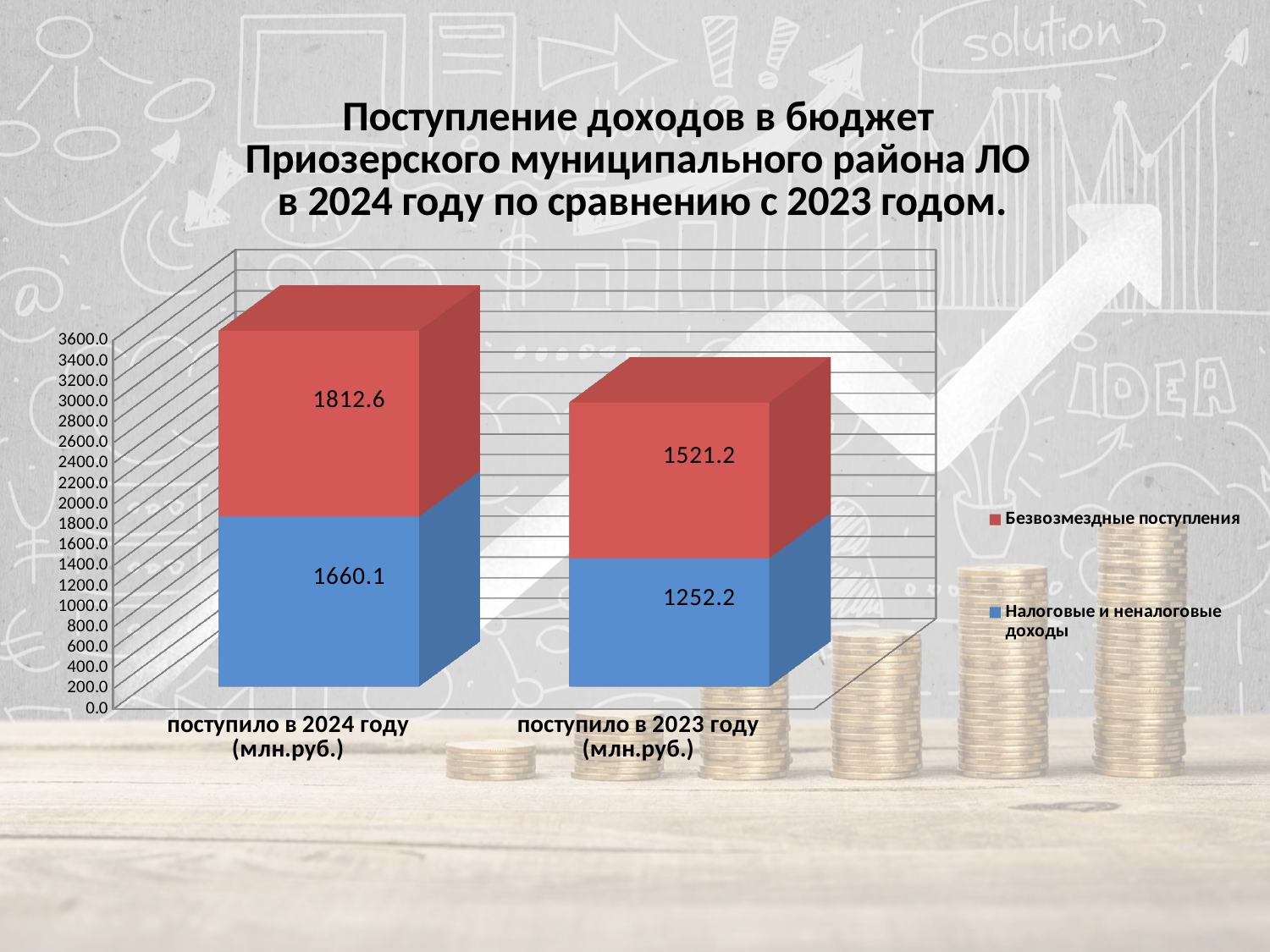
What is the difference between Безвозмездные поступления in 2024 and in 2023? 291.4 What kind of chart is shown on the slide? Stacked bar chart How many categories are shown on the x axis? 2 Which category has the higher value for Безвозмездные поступления: поступило в 2024 году or поступило в 2023 году? поступило в 2024 году (млн.руб.) What is the value of Безвозмездные поступления for поступило в 2024 году (млн.руб.)? 1812.6 What is the total of the stacked bar for поступило в 2023 году (млн.руб.)? 2773.4 What is the value of Безвозмездные поступления for поступило в 2023 году (млн.руб.)? 1521.2 What is the total of the stacked bar for поступило в 2024 году (млн.руб.)? 3472.7 What is the value of Налоговые и неналоговые доходы for поступило в 2023 году (млн.руб.)? 1252.2 By how much did Налоговые и неналоговые доходы in 2024 exceed the 2023 value? 407.9 What is the value of Налоговые и неналоговые доходы for поступило в 2024 году (млн.руб.)? 1660.1 How many series does the legend list? 2